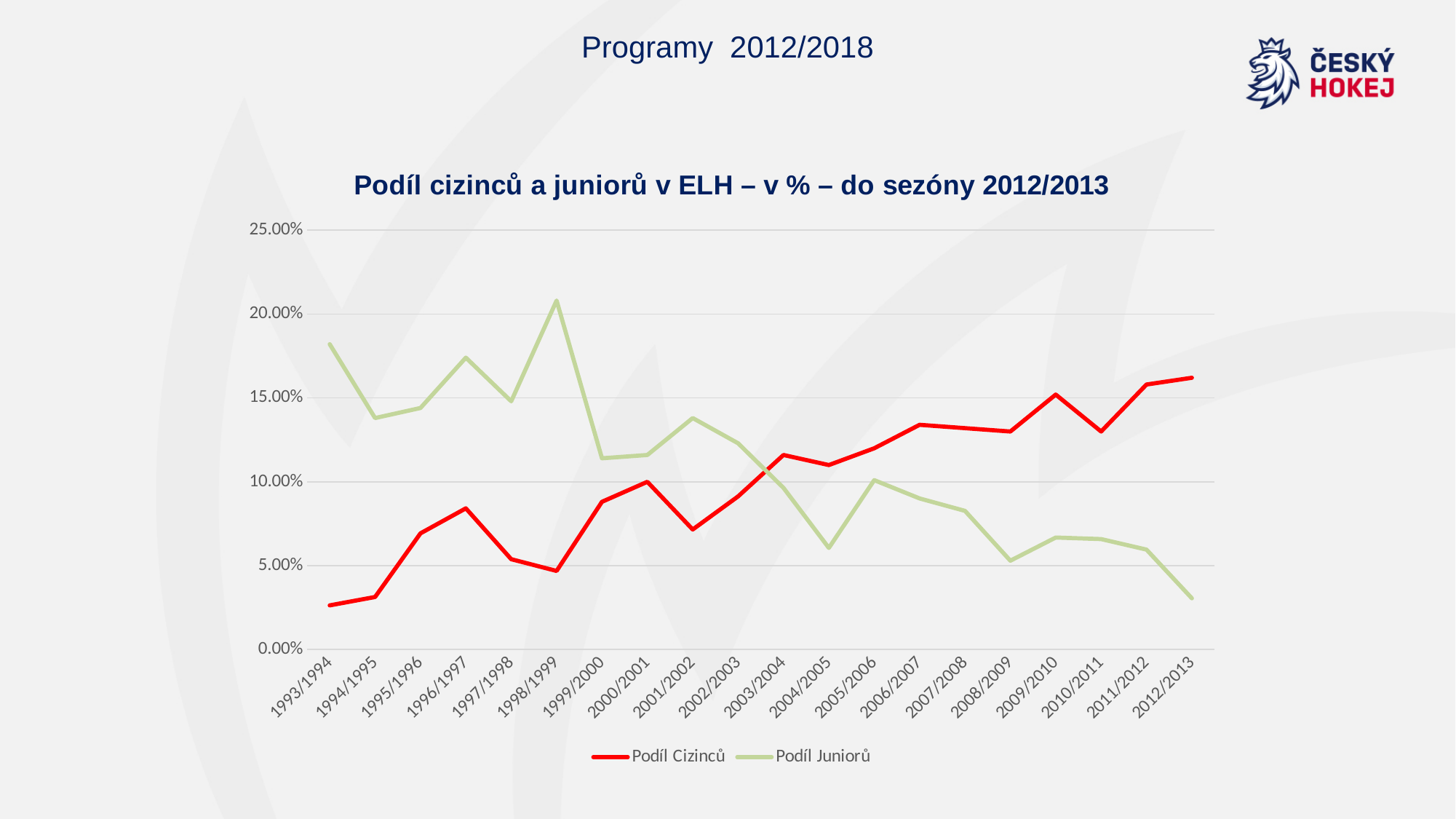
Is the value for Podíl Cizinců in 2012/2013 greater or less than 15.00%? greater What kind of chart is shown on the slide? Line chart Is the value for Podíl Juniorů in 1998/1999 greater or less than 20.00%? greater How many seasons are plotted along the x axis? 20 How many series does the legend list? 2 Is the value for Podíl Cizinců in 1993/1994 greater or less than 5.00%? less In 1993/1994, which series has the larger value, Podíl Cizinců or Podíl Juniorů? Podíl Juniorů Does the value for Podíl Cizinců generally rise or fall from 1993/1994 to 2012/2013? Rise In which season is the value for Podíl Juniorů lowest? 2012/2013 In which season is the value for Podíl Juniorů highest? 1998/1999 What is the title of the chart? Podíl cizinců a juniorů v ELH – v % – do sezóny 2012/2013 Which series is drawn in red? Podíl Cizinců